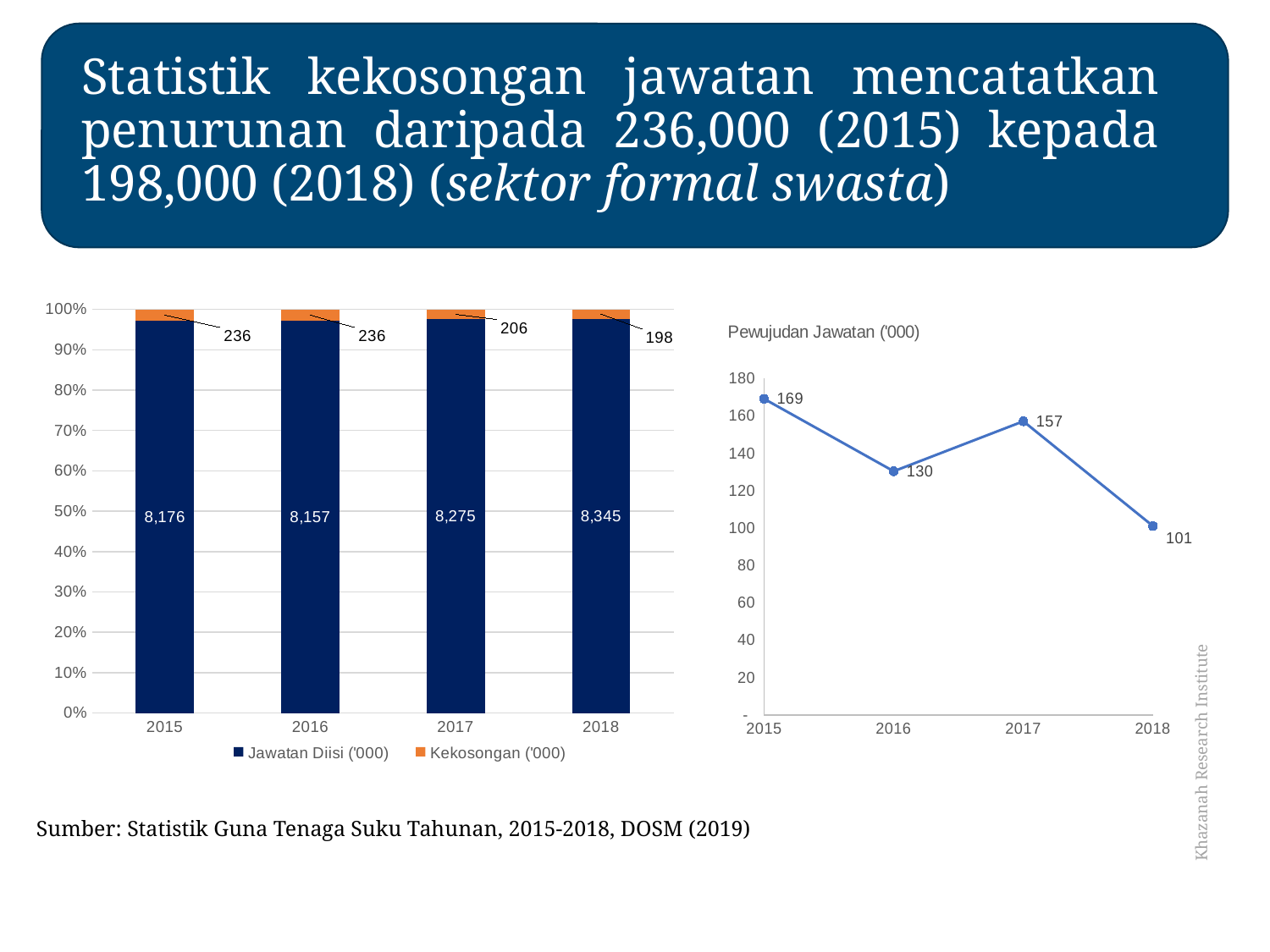
In the left stacked bar chart, what is the value of Kekosongan ('000) for 2018? 198 In the chart titled Pewujudan Jawatan ('000), what is the value for 2016? 130 In the chart titled Pewujudan Jawatan ('000), is the value for 2017 greater or less than 140? greater In the left stacked bar chart, what is the value of Jawatan Diisi ('000) for 2017? 8,275 In the left stacked bar chart, which year has the lowest value for Kekosongan ('000)? 2018 In the chart titled Pewujudan Jawatan ('000), which year has the lowest value? 2018 In the left stacked bar chart, how many series does the legend list? 2 What kind of chart is the chart titled Pewujudan Jawatan ('000)? Line chart In the left stacked bar chart, what is the total of Jawatan Diisi ('000) and Kekosongan ('000) for 2018? 8,543 In the left stacked bar chart, which year has the highest value for Jawatan Diisi ('000)? 2018 In the chart titled Pewujudan Jawatan ('000), what is the difference between the values for 2015 and 2018? 68 In the left stacked bar chart, what is the difference between the Kekosongan ('000) values for 2016 and 2017? 30